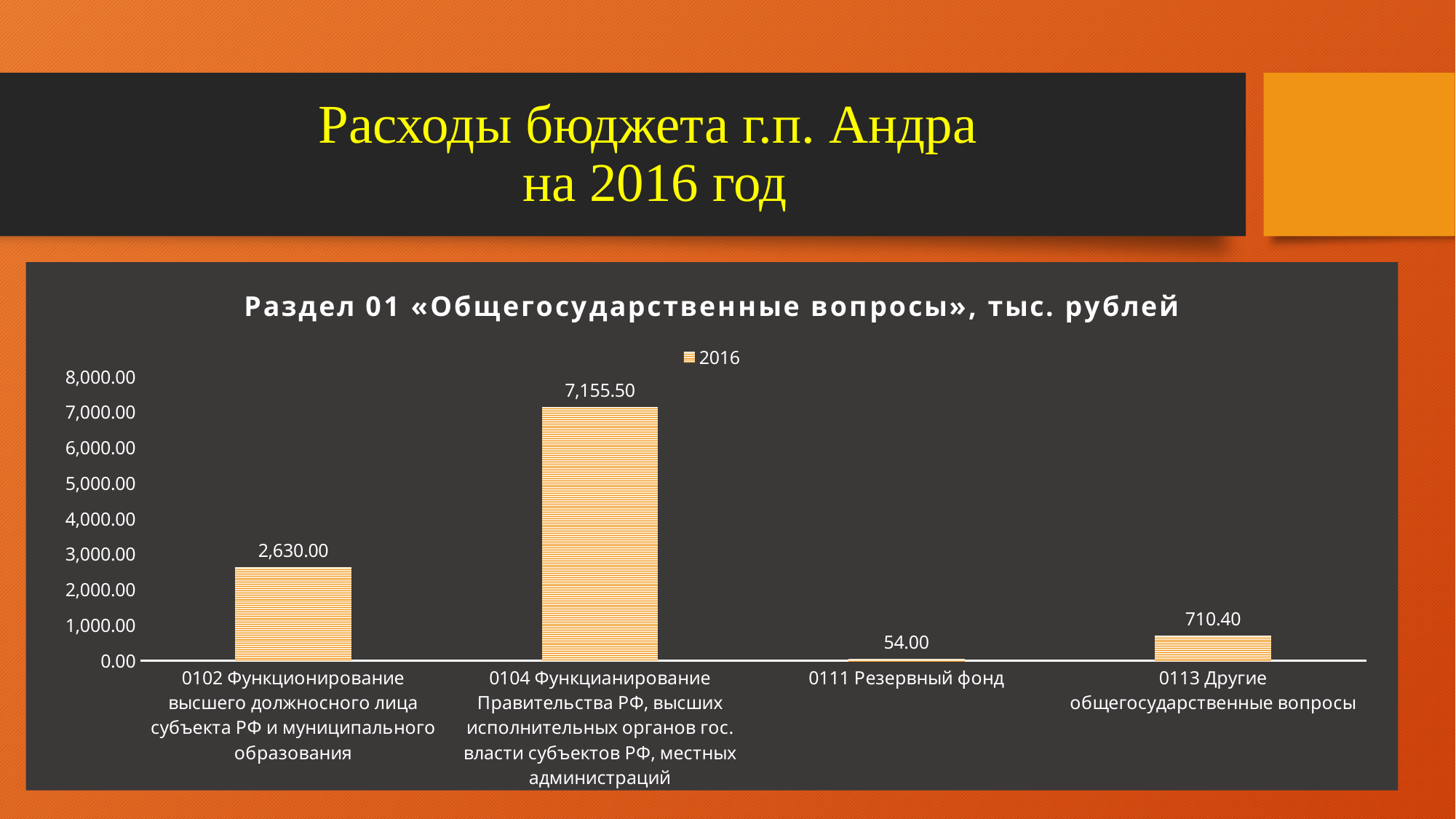
What is the difference between the values for 0104 and 0102? 4,525.50 How many series does the legend list? 1 How many categories are shown on the chart? 4 What is the value for 0111 Резервный фонд? 54.00 What is the value for 0102 Функционирование высшего должностного лица субъекта РФ и муниципального образования? 2,630.00 Which category has the lowest value? 0111 Резервный фонд Which is larger, the value for 0102 or the value for 0113? 0102 What kind of chart is shown on the slide? bar chart Which category has the highest value? 0104 Функцианирование Правительства РФ, высших исполнительных органов гос. власти субъектов РФ, местных администраций What is the difference between the values for 0113 Другие общегосударственные вопросы and 0111 Резервный фонд? 656.40 Is the value for 0104 greater or less than 7,000.00? greater What is the value for 0113 Другие общегосударственные вопросы? 710.40